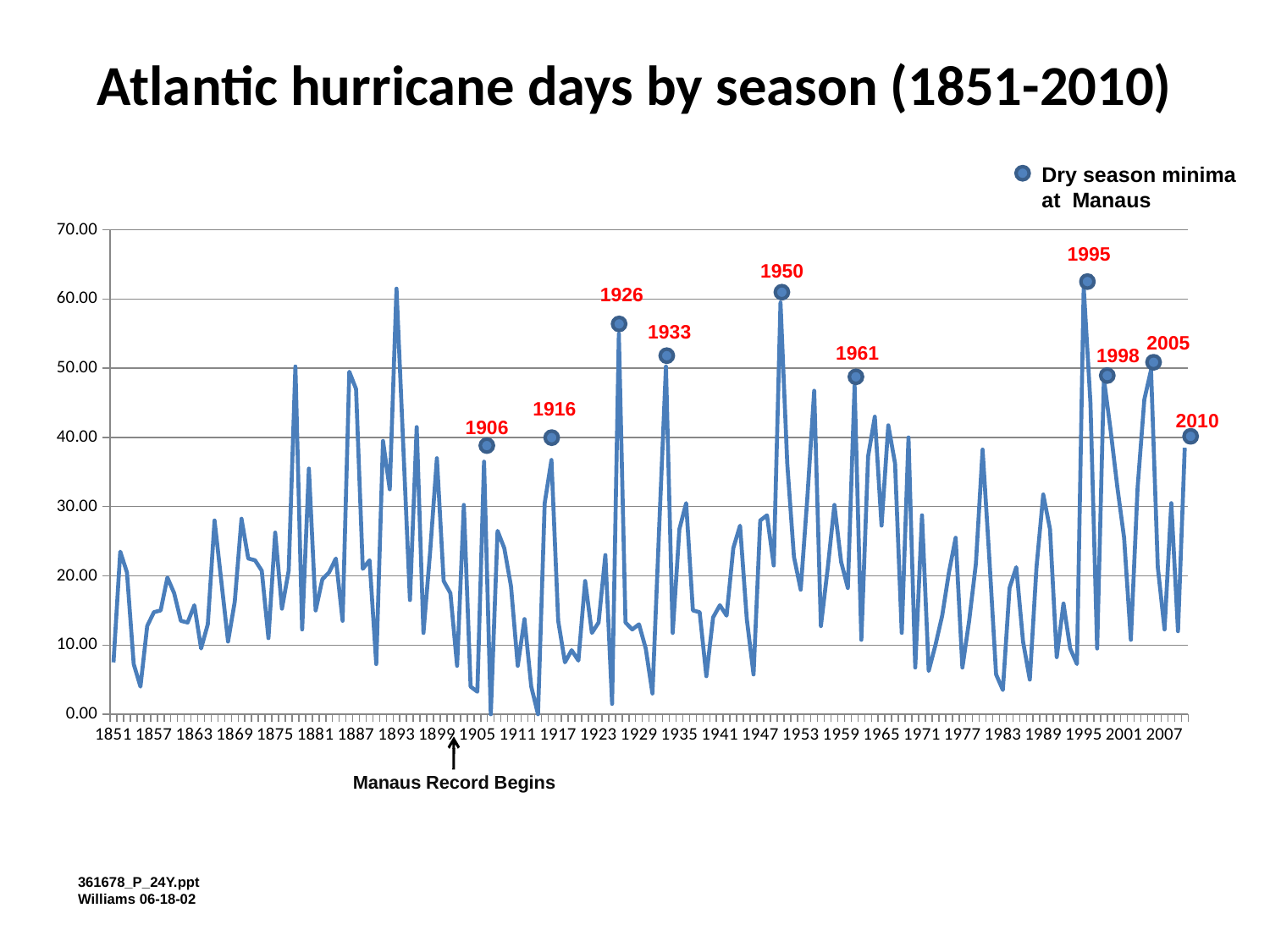
Is the value for 2010 greater or less than 30? greater How many years are marked with a circle as dry season minima at Manaus? 10 Which has the larger value, 1950 or 1961? 1950 What kind of chart is shown on the slide? line chart Is the value for 1916 greater or less than 30? greater Is the value for 1926 greater or less than 50? greater What is the title of the chart? Atlantic hurricane days by season (1851-2010) Which has the larger value, 1926 or 1906? 1926 What does the legend entry with the circular marker represent? Dry season minima at Manaus